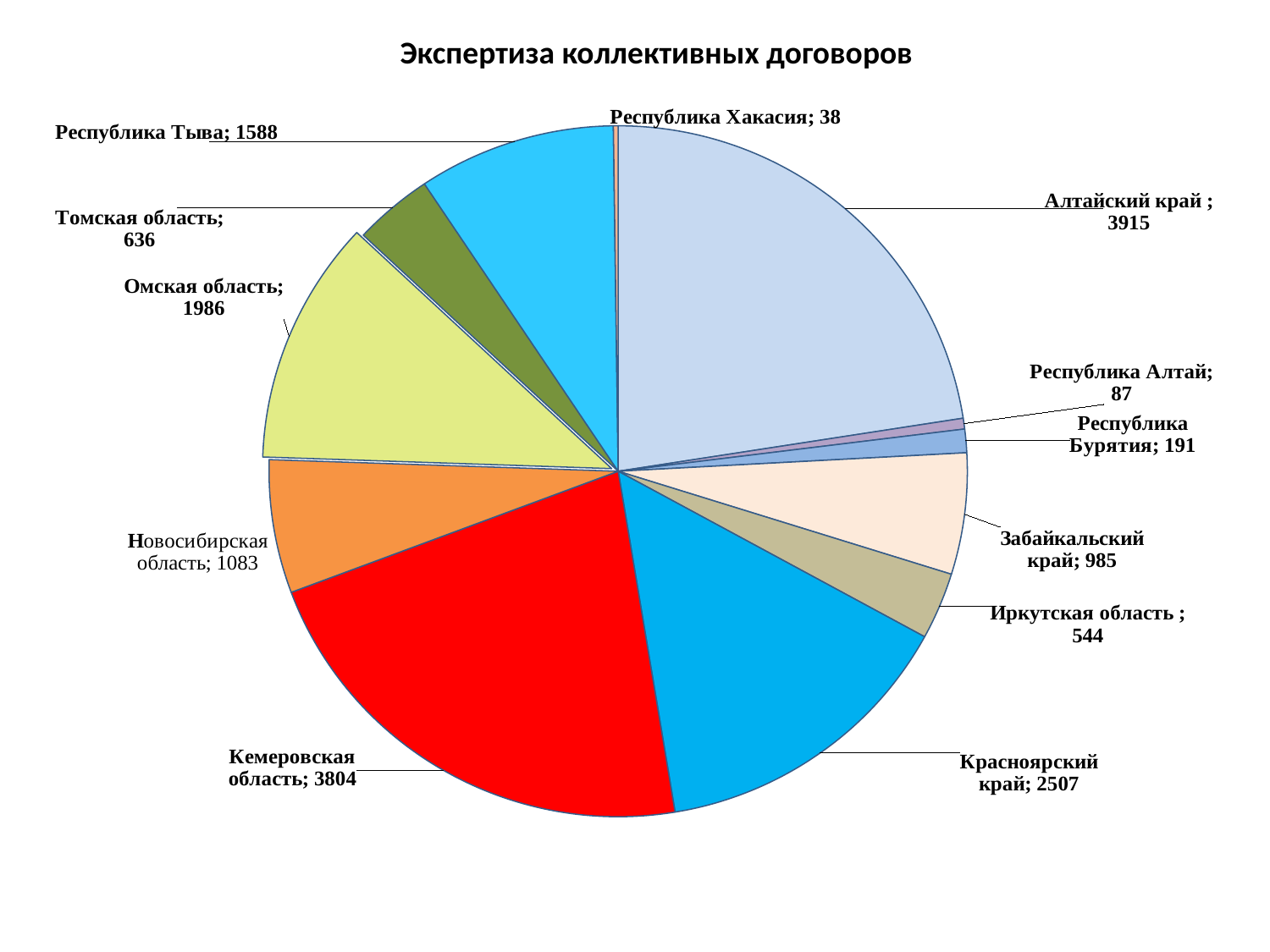
What is the title of the chart? Экспертиза коллективных договоров Which is larger, the value for Красноярский край or the value for Омская область? Красноярский край Which region has the largest value? Алтайский край What type of chart is shown on the slide? Pie chart Which region has the smallest value? Республика Хакасия What is the difference between the values for Республика Тыва and Новосибирская область? 505 What is the value for Кемеровская область? 3804 How many slices (regions) does the pie chart have? 12 What is the value for Алтайский край? 3915 What is the value for Томская область? 636 What is the value for Республика Бурятия? 191 What is the difference between the values for Алтайский край and Кемеровская область? 111